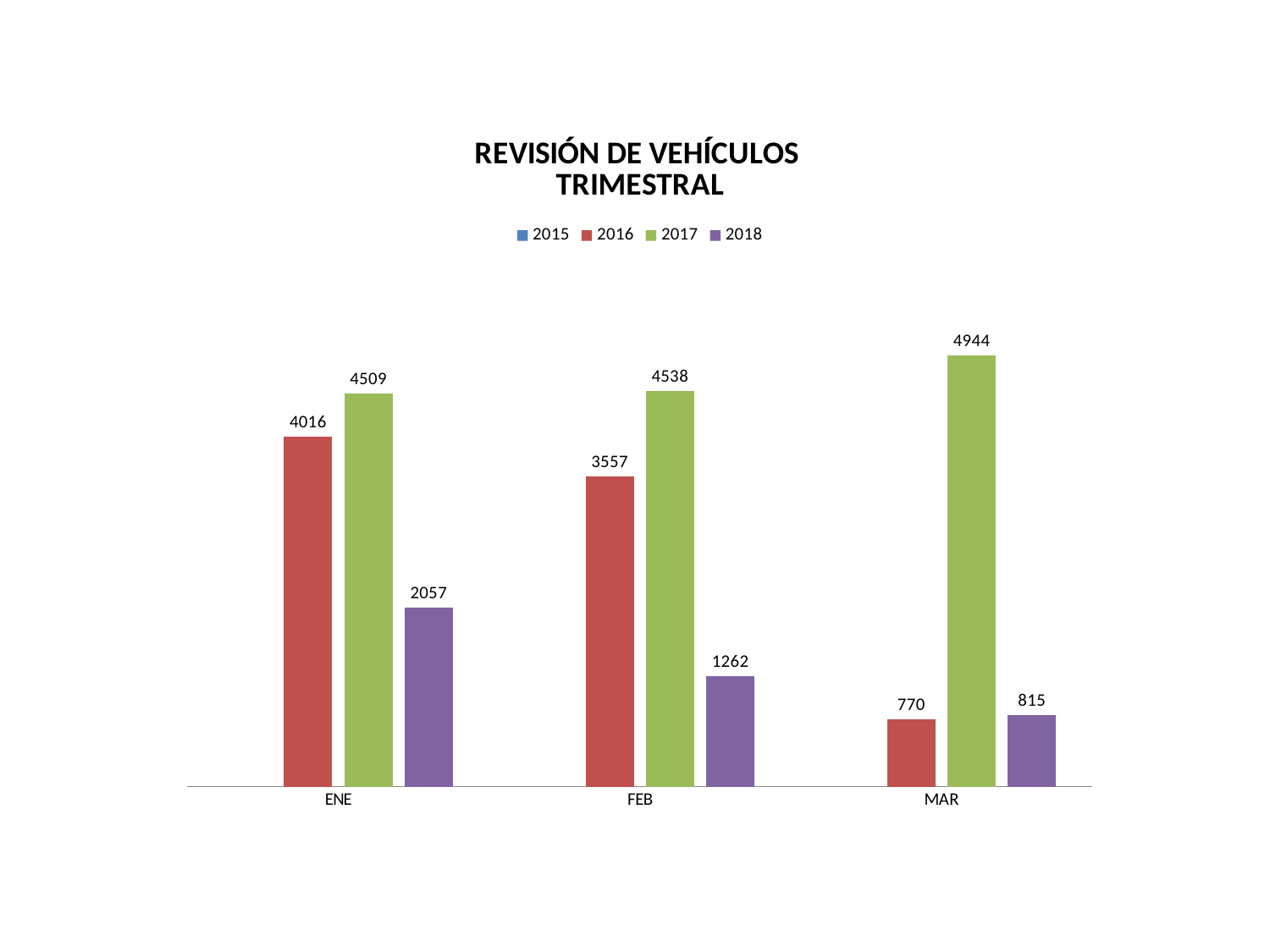
Which is larger in MAR, the 2016 value or the 2018 value? 2018 What kind of chart is this? bar chart In which month is the 2016 value lowest? MAR What is the difference between the 2018 values in ENE and FEB? 795 What is the value for 2016 in FEB? 3557 What is the value for 2017 in ENE? 4509 How many months are shown on the x axis? 3 In which month is the 2017 value highest? MAR What is the difference between the 2017 and 2016 values in ENE? 493 What is the value for 2018 in ENE? 2057 What is the value for 2018 in MAR? 815 How many series does the legend list? 4